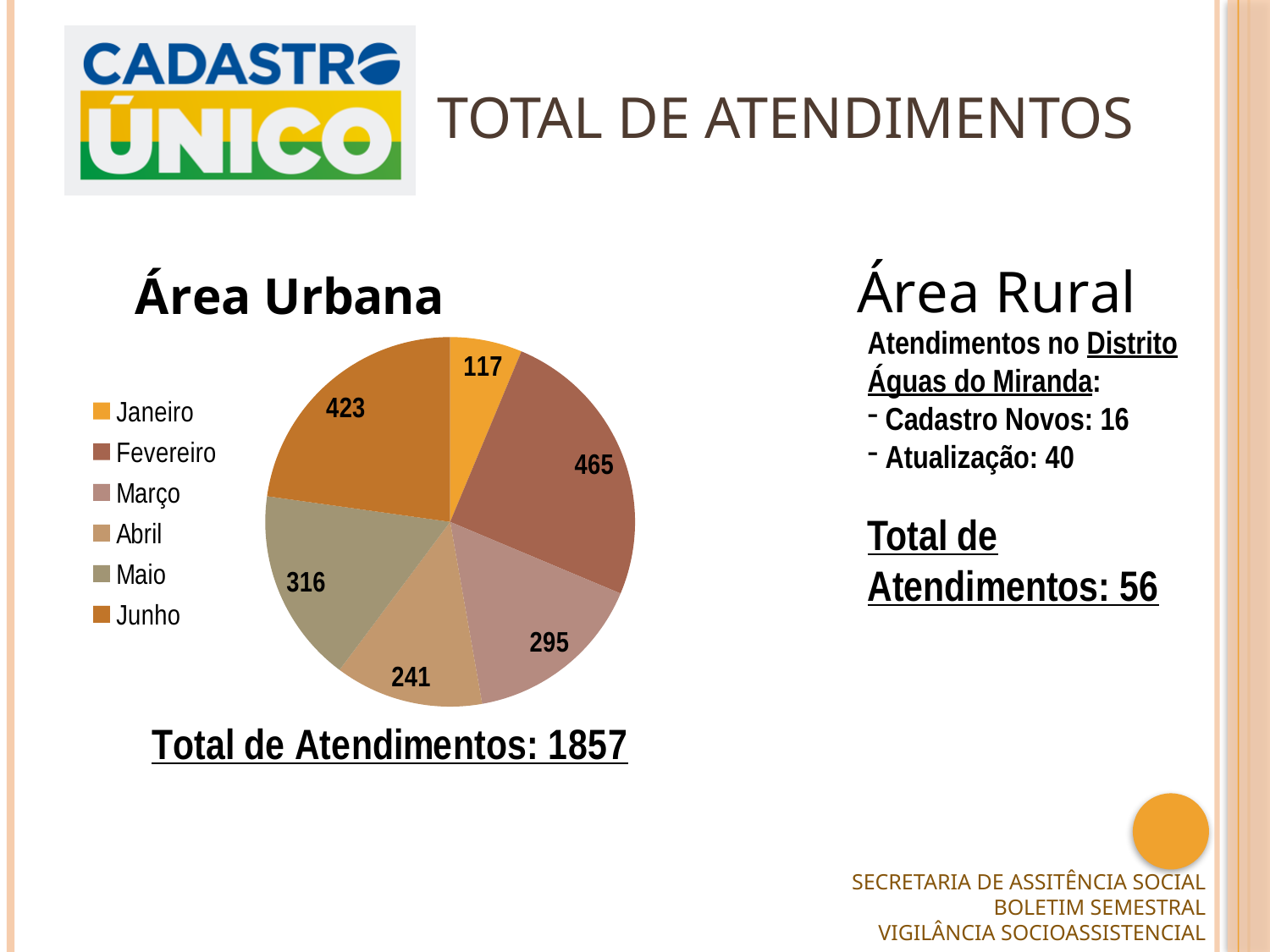
What type of chart is shown under the heading Área Urbana? pie chart In the Área Urbana pie chart, what is the value for Abril? 241 Which month has the smallest slice in the Área Urbana pie chart? Janeiro How many entries does the legend of the Área Urbana pie chart list? 6 In the Área Urbana pie chart, what is the value for Maio? 316 What is the total of all slices in the Área Urbana pie chart? 1857 What is the title shown above the pie chart on the slide? Área Urbana Which month has the largest slice in the Área Urbana pie chart? Fevereiro How many slices does the Área Urbana pie chart have? 6 In the Área Urbana pie chart, what is the value for Fevereiro? 465 In the Área Urbana pie chart, which is larger, the value for Maio or the value for Abril? Maio In the Área Urbana pie chart, what is the difference between the values for Junho and Março? 128